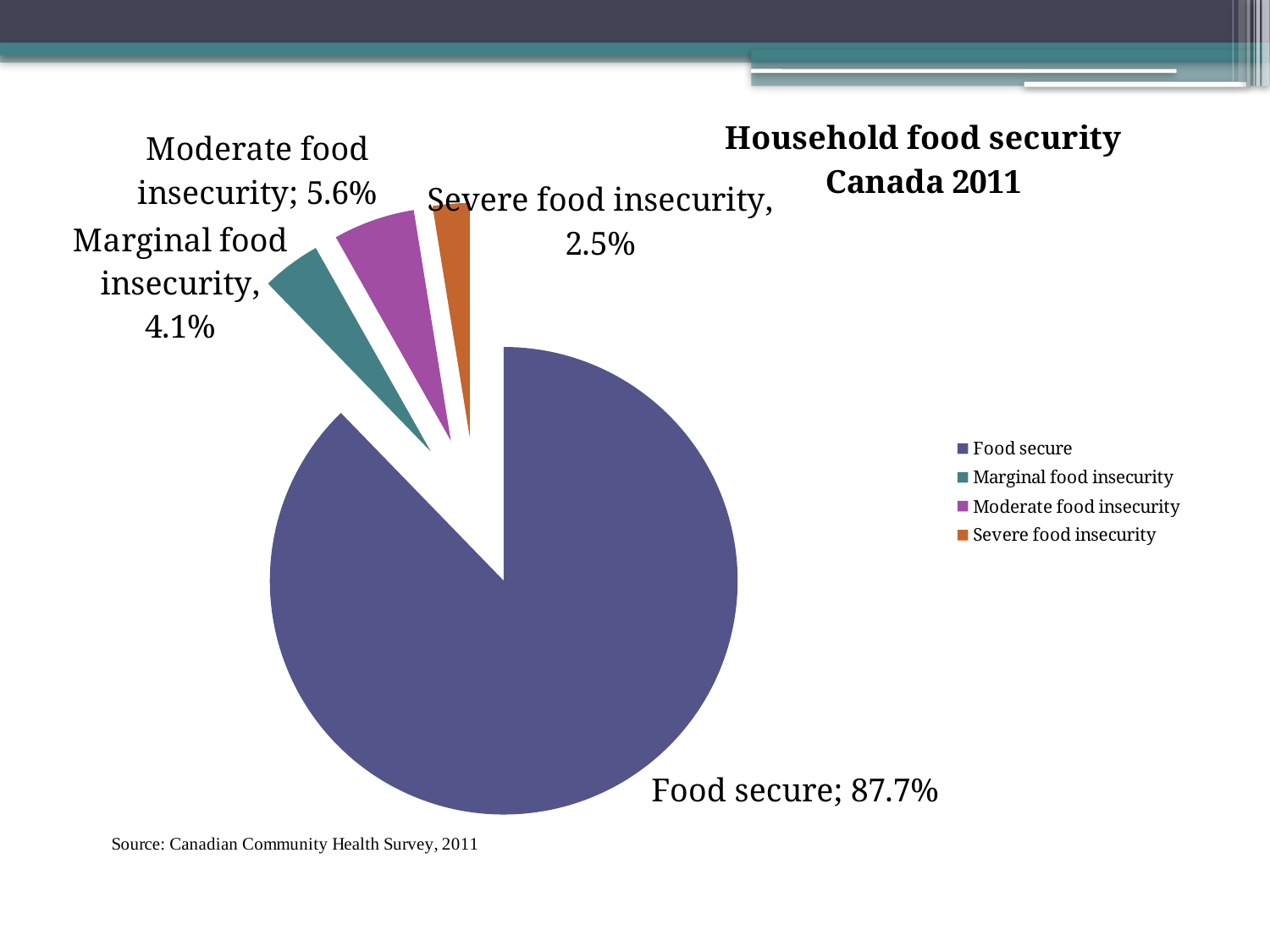
Which is larger, Marginal food insecurity or Moderate food insecurity? Moderate food insecurity What is the title of the chart? Household food security Canada 2011 What is the source cited for the chart data? Canadian Community Health Survey, 2011 What is the value for Marginal food insecurity? 4.1% Which category has the smallest share of the pie? Severe food insecurity How many categories does the pie chart show? 4 What is the value for Moderate food insecurity? 5.6% What is the value for Severe food insecurity? 2.5% What percentage of households are food secure? 87.7% What kind of chart is shown on the slide? Pie chart Which category has the largest share of the pie? Food secure What is the difference between Moderate food insecurity and Severe food insecurity? 3.1%